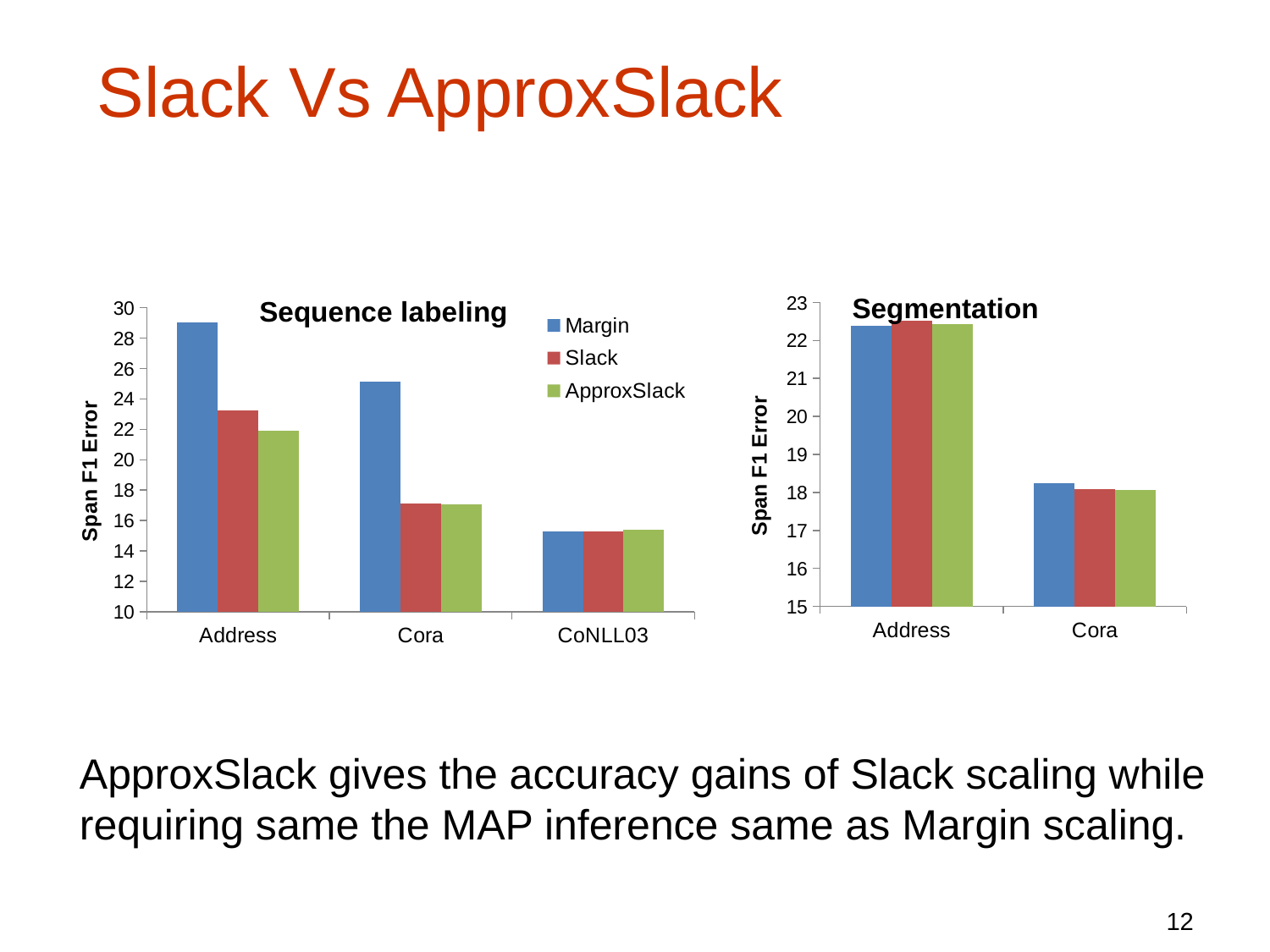
In the Segmentation chart, is the Margin value for Cora greater or less than 19? less How many series does the legend of the Sequence labeling chart list? 3 What kind of chart is the Sequence labeling chart? bar chart In the Sequence labeling chart, which is larger for Cora: Margin or ApproxSlack? Margin In the Segmentation chart, which category has the lowest ApproxSlack value? Cora How many categories are shown on the x axis of the Sequence labeling chart? 3 How many categories are shown on the x axis of the Segmentation chart? 2 In the Sequence labeling chart, which category has the highest Margin value? Address In the Sequence labeling chart, is the Margin value for Address greater or less than 28? greater In the Sequence labeling chart, is the Slack value for Cora greater or less than 18? less What is the y-axis label of the Segmentation chart? Span F1 Error